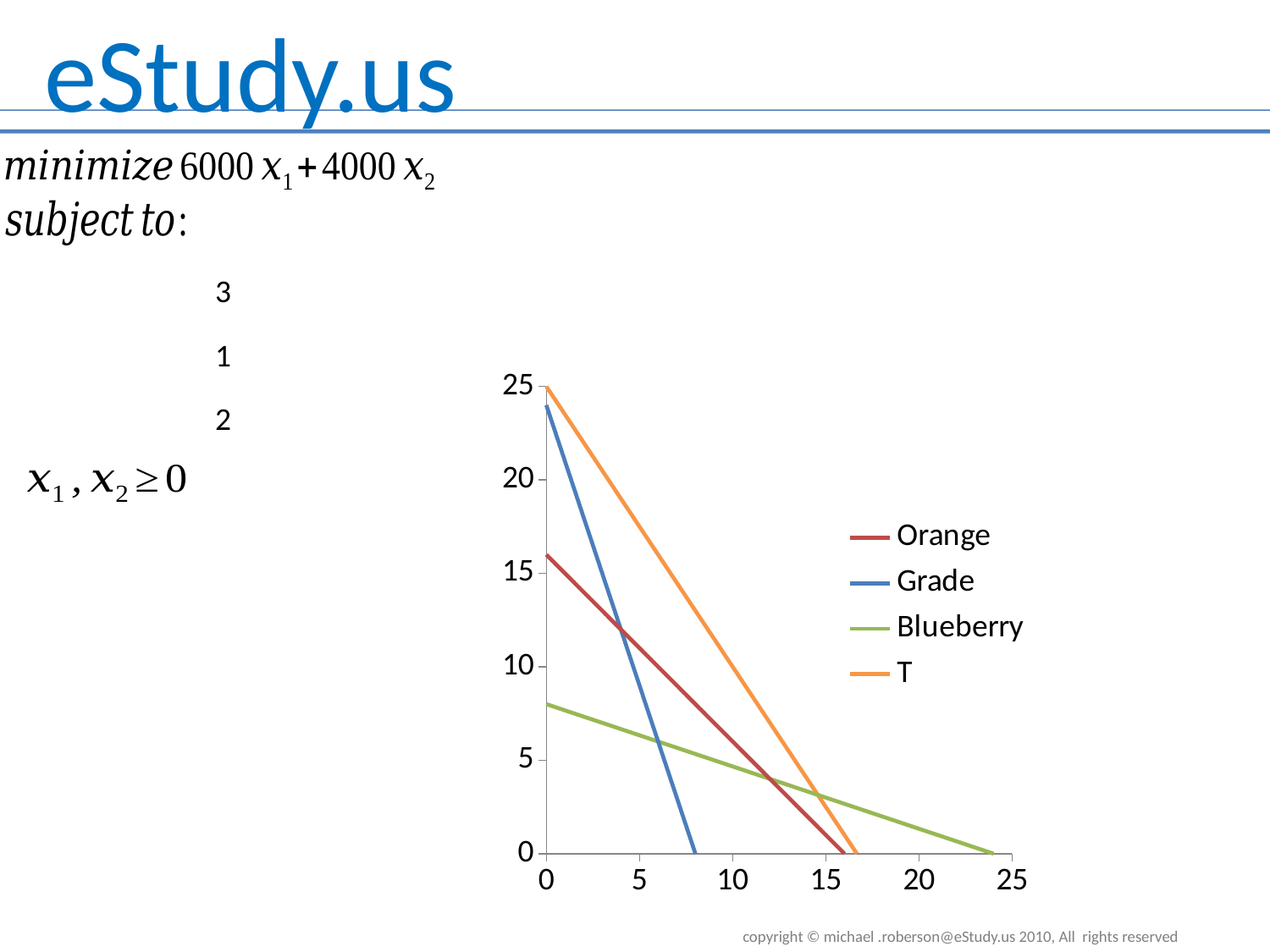
Which series has the lowest value at x = 0? Blueberry Is the x value where the Grade line reaches zero greater or less than 10? less How many series does the chart legend list? 4 What is the value of the T line where it meets the vertical axis (at x = 0)? 25 Which series has the highest value at x = 0? T Is the value of the Grade line at x = 0 greater or less than 20? greater Do the plotted lines rise or fall as x increases? fall What colour is the line for the Blueberry series? green Which series reaches the horizontal axis furthest to the right? Blueberry What kind of chart is shown on the slide? line chart At x = 0, which is larger: the Grade line or the Orange line? Grade Is the value of the Blueberry line at x = 0 greater or less than 10? less